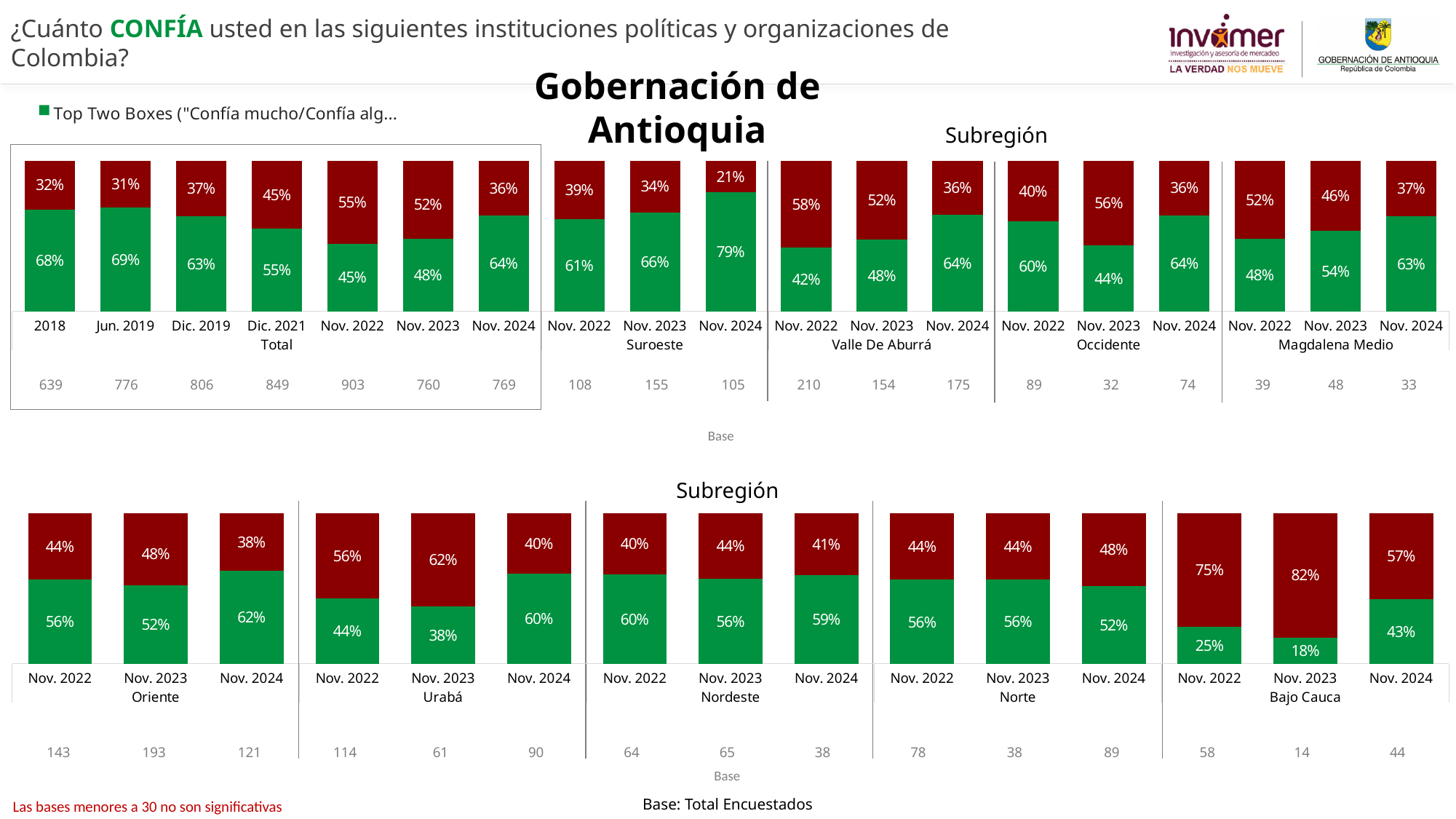
In the bottom chart, how does the green (Top Two Boxes) value for Bajo Cauca change from Nov. 2022 to Nov. 2024? Falls to 18% in Nov. 2023, then rises to 43% in Nov. 2024 In the top chart, which Total period has the highest green (Top Two Boxes) value? Jun. 2019 In the bottom chart, what is the total of the stacked bar for Nordeste in Nov. 2022? 100% In the top chart, what is the green (Top Two Boxes) value for Total in 2018? 68% In the top chart, what is the green (Top Two Boxes) value for Valle De Aburrá in Nov. 2024? 64% In the bottom chart, is the green value for Urabá in Nov. 2023 larger or smaller than the green value for Oriente in Nov. 2023? smaller In the bottom chart, what is the green (Top Two Boxes) value for Bajo Cauca in Nov. 2023? 18% What type of chart is used on this slide? Stacked bar chart In the top chart, what is the difference between the green values for Total in Nov. 2024 and Nov. 2023? 16% In the bottom chart, which subregion has the lowest green (Top Two Boxes) value in Nov. 2024? Bajo Cauca In the top chart, what is the red segment value for Suroeste in Nov. 2024? 21% In the top chart, which Total period has the lowest green (Top Two Boxes) value? Nov. 2022